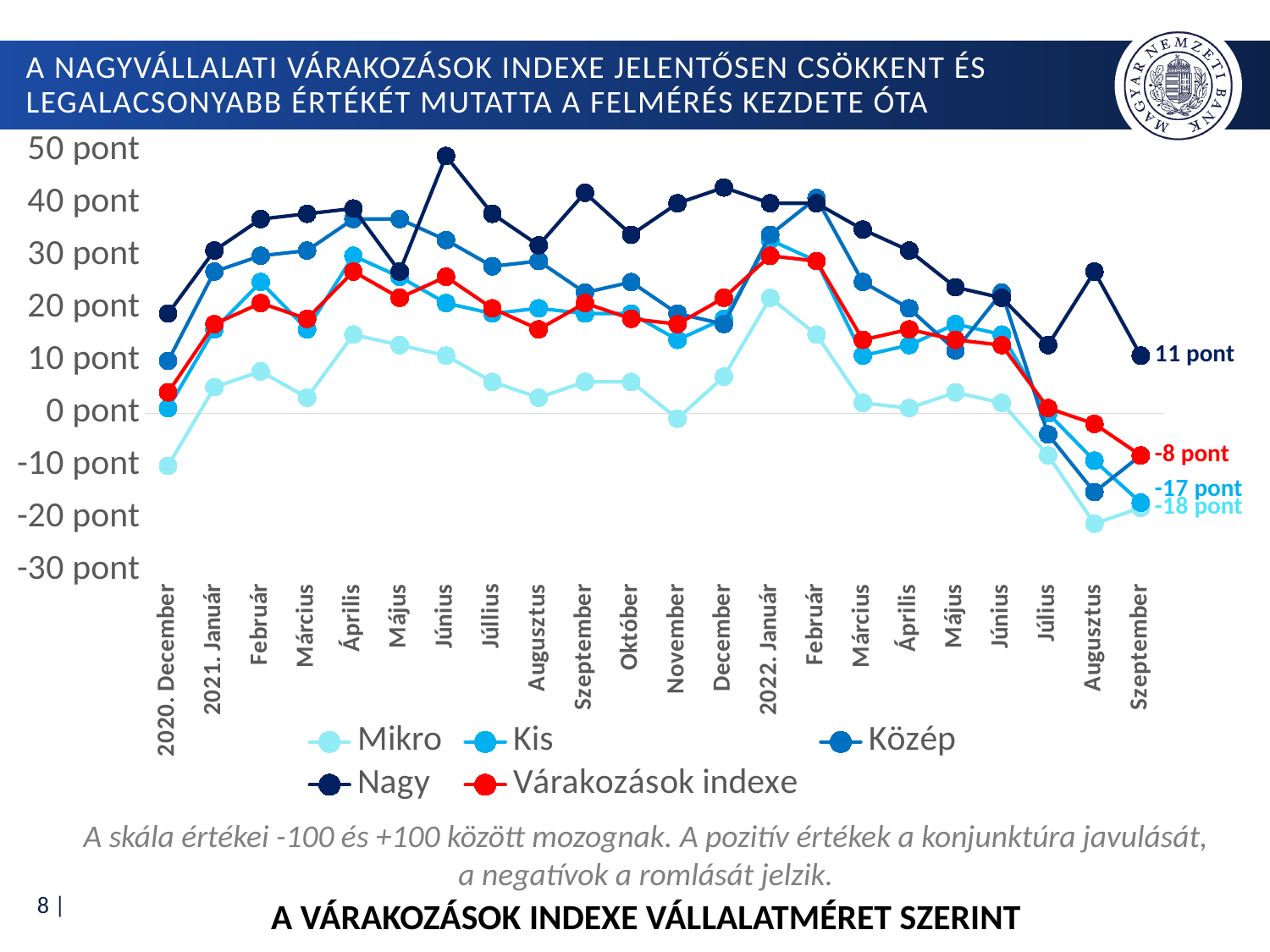
Is the value of the Nagy series in 2021 Június greater or less than 40 pont? greater Which series has the highest value in 2022 Szeptember? Nagy Which series has the higher value in 2022 Szeptember, Nagy or Kis? Nagy What is the value of the Várakozások indexe series in 2022 Szeptember? -8 pont What is the value of the Közép series in 2022 Szeptember? -8 pont Does the Várakozások indexe series rise or fall from 2022 Február to 2022 Szeptember? fall What is the difference between the Nagy value and the Várakozások indexe value in 2022 Szeptember? 19 pont What is the value of the Nagy series in 2022 Szeptember? 11 pont How many series does the legend list? 5 What is the value of the Kis series in 2022 Szeptember? -17 pont How many months are shown on the x axis? 22 What kind of chart is shown on the slide? line chart